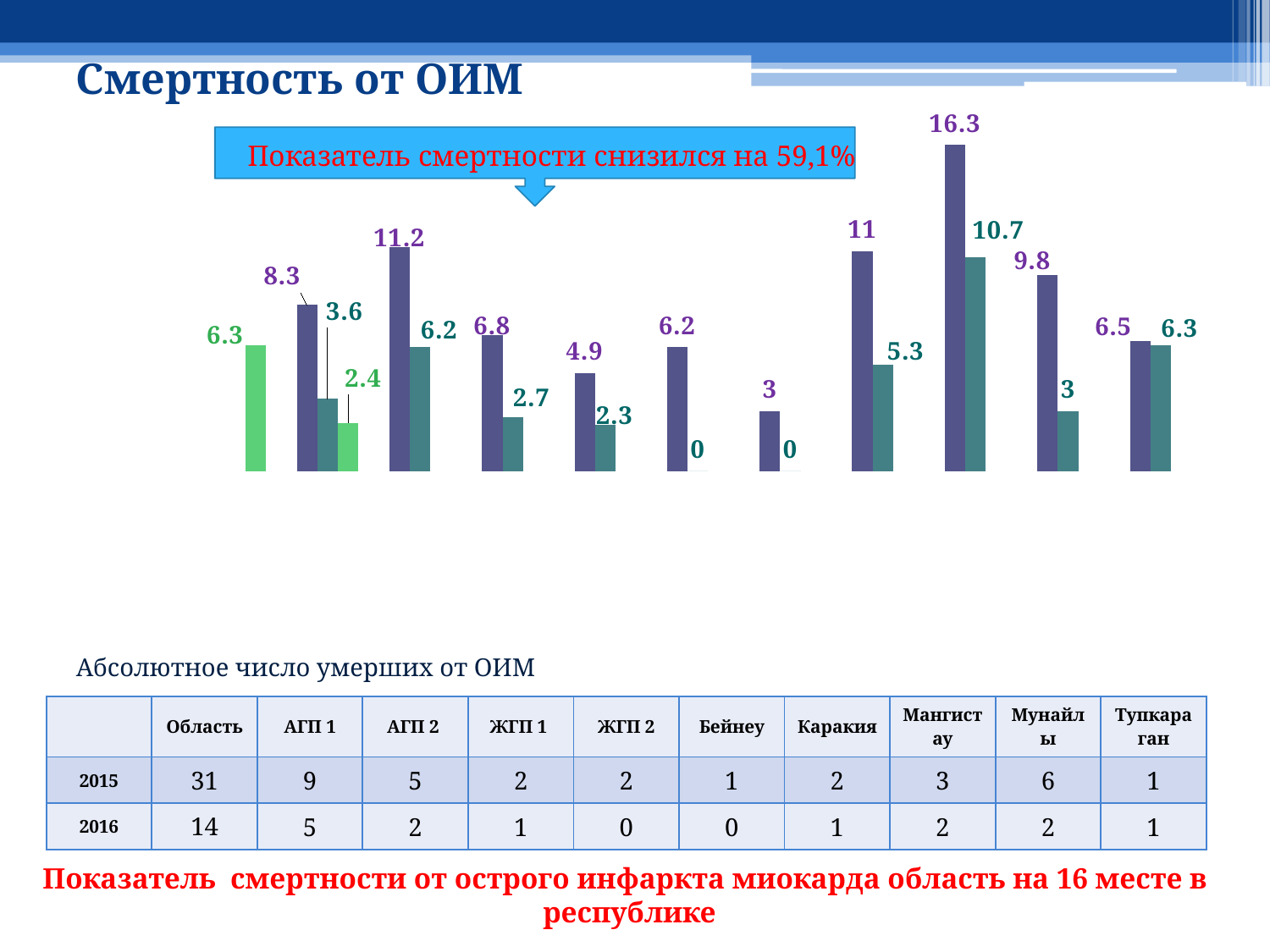
What is the value of the teal bar immediately to the right of the tallest bar (16.3)? 10.7 How many bars on the chart are labeled 0? 2 In the group of bars labeled 11 and 5.3, which bar is taller, the purple one or the teal one? the purple one (11) What kind of chart is shown on the slide? bar chart What is the value of the rightmost purple bar on the chart? 6.5 What is the lowest value labeled on the chart? 0 What does the blue callout box above the chart say? Показатель смертности снизился на 59,1% What is the value of the leftmost green bar on the chart? 6.3 What is the difference between the tallest bar (16.3) and the teal bar next to it (10.7)? 5.6 What is the title of the slide containing the chart? Смертность от ОИМ In the group of bars labeled 8.3, 3.6 and 2.4, what is the difference between the first two values? 4.7 What is the highest value labeled on the chart? 16.3